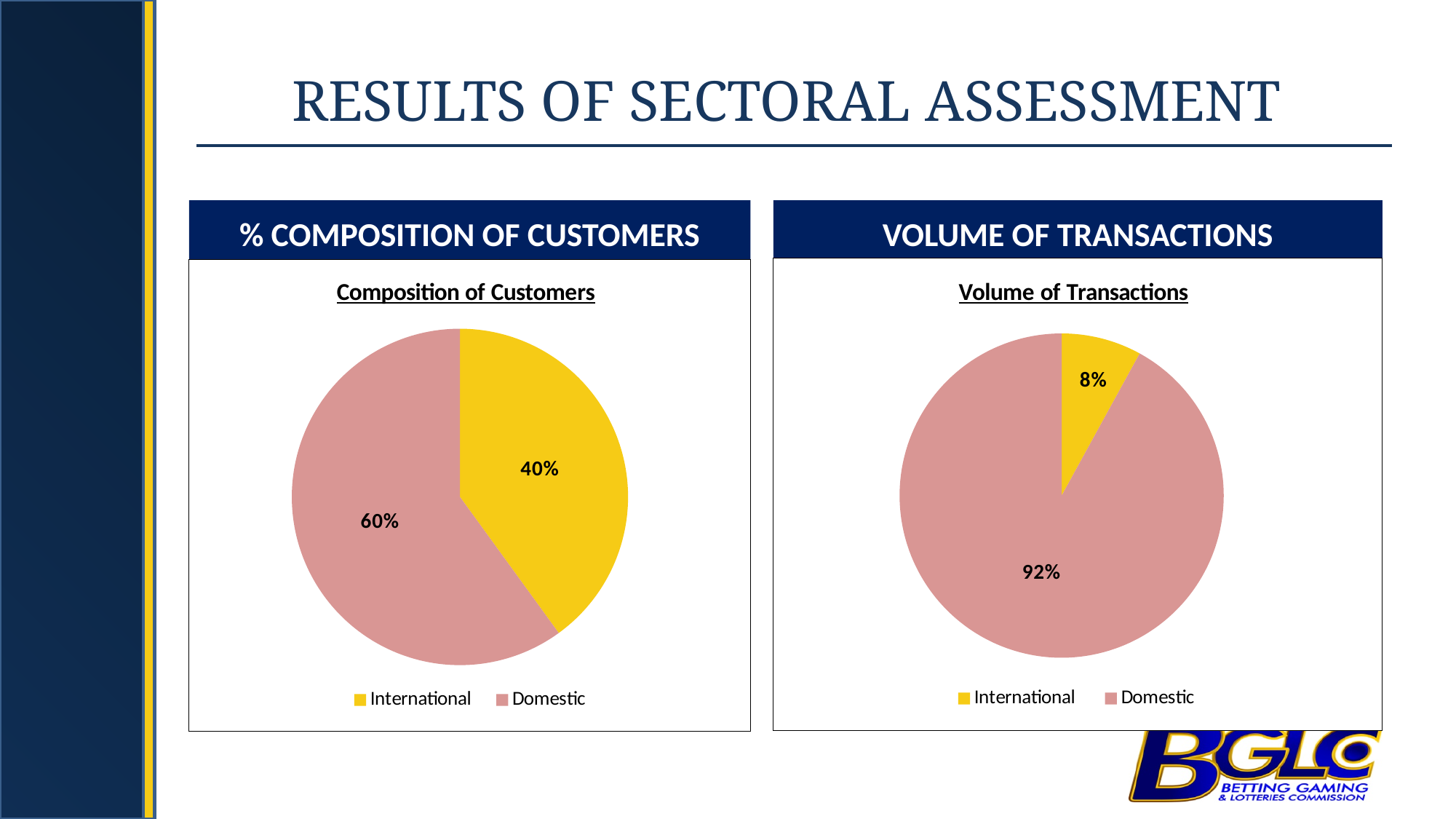
In the Composition of Customers chart, what colour represents International? Yellow In the Volume of Transactions chart, what is the difference between the Domestic and International shares? 84% In the Composition of Customers chart, what is the difference between the Domestic and International shares? 20% In the Volume of Transactions chart, which category has the smallest slice? International What type of chart is the Composition of Customers chart? Pie chart In the Volume of Transactions chart, what share of transactions is International? 8% In the Volume of Transactions chart, which is larger, the Domestic or the International slice? Domestic In the Composition of Customers chart, what share of customers is International? 40% In the Volume of Transactions chart, what share of transactions is Domestic? 92% How many categories does the legend of the Volume of Transactions chart list? 2 In the Composition of Customers chart, which category has the largest slice? Domestic In the Composition of Customers chart, what share of customers is Domestic? 60%